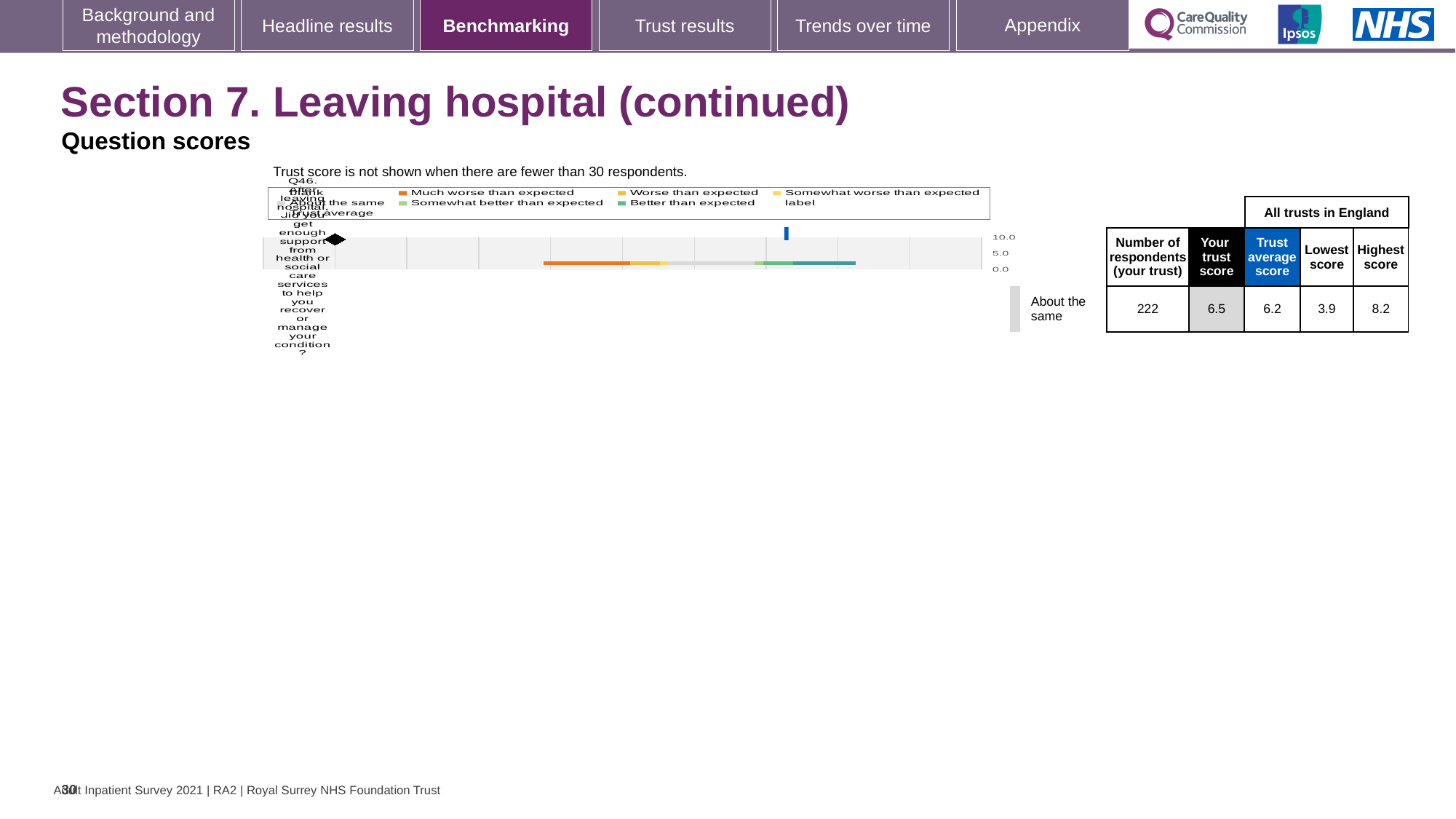
How many respondents from the trust answered Q46? 222 What is the highest value shown on the chart's score axis? 10.0 What is the lowest score among all trusts in England for Q46? 3.9 What is the trust's score for Q46 shown in the table next to the chart? 6.5 Is the trust's score for Q46 higher or lower than the trust average score? higher Which benchmark category is the trust's Q46 result labelled as on the slide? About the same What is the highest score among all trusts in England for Q46? 8.2 What kind of chart is used to show the Q46 benchmarking result? bar chart What is the trust average score for Q46 across all trusts in England? 6.2 What is the difference between the highest score and the lowest score for Q46? 4.3 By how much does the trust's score for Q46 exceed the trust average score? 0.3